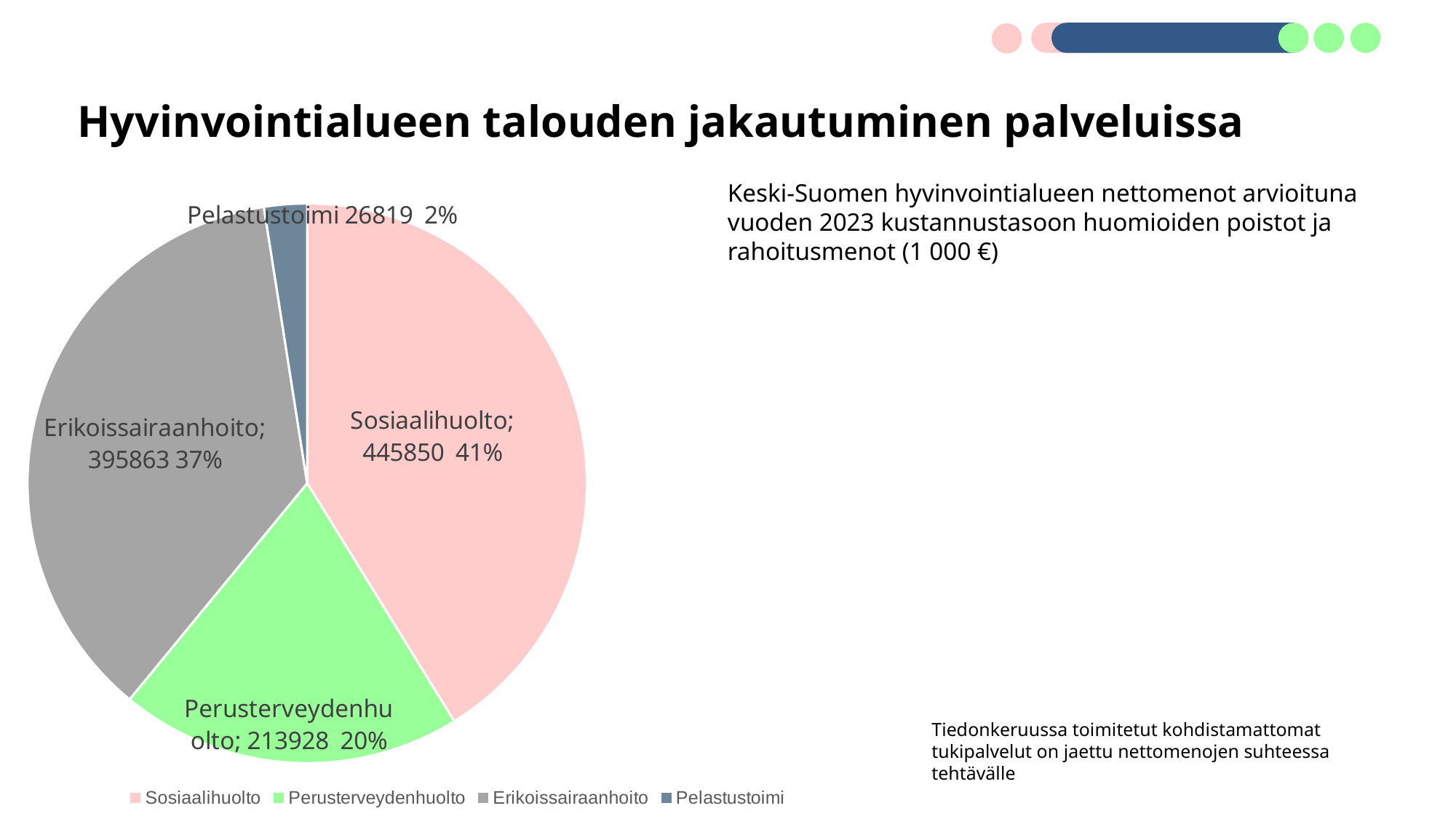
What share of the pie does Erikoissairaanhoito represent? 37% What is the difference between the values for Sosiaalihuolto and Erikoissairaanhoito? 49987 What is the value for Erikoissairaanhoito? 395863 Which category has the smallest slice? Pelastustoimi Which is larger, the value for Perusterveydenhuolto or the value for Erikoissairaanhoito? Erikoissairaanhoito How many slices does the pie chart have? 4 What share of the pie does Pelastustoimi represent? 2% Which category has the largest slice? Sosiaalihuolto What is the value for Perusterveydenhuolto? 213928 What is the value for Sosiaalihuolto? 445850 What is the value for Pelastustoimi? 26819 What kind of chart is shown on the slide? pie chart